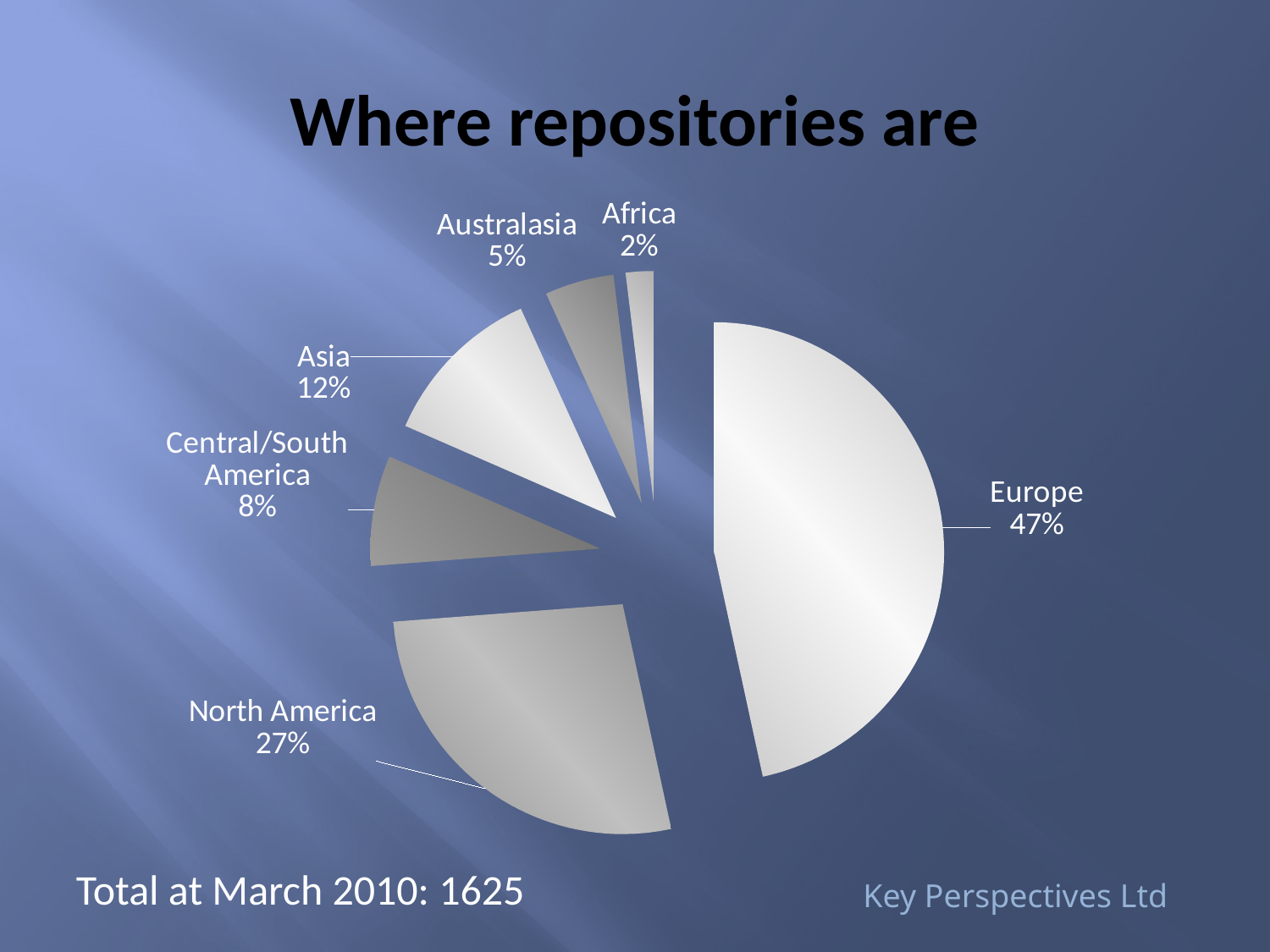
What is the title of the chart? Where repositories are Which region has the largest share of repositories? Europe What share of repositories is in Asia? 12% What share of repositories is in Africa? 2% How many regions are shown in the pie chart? 6 What kind of chart is shown on the slide? Pie chart Which has a larger share, Asia or Australasia? Asia What share of repositories is in Central/South America? 8% What share of repositories is in North America? 27% What is the difference in percentage points between Europe's share and North America's share? 20 What share of repositories is in Europe? 47% Which region has the smallest share of repositories? Africa